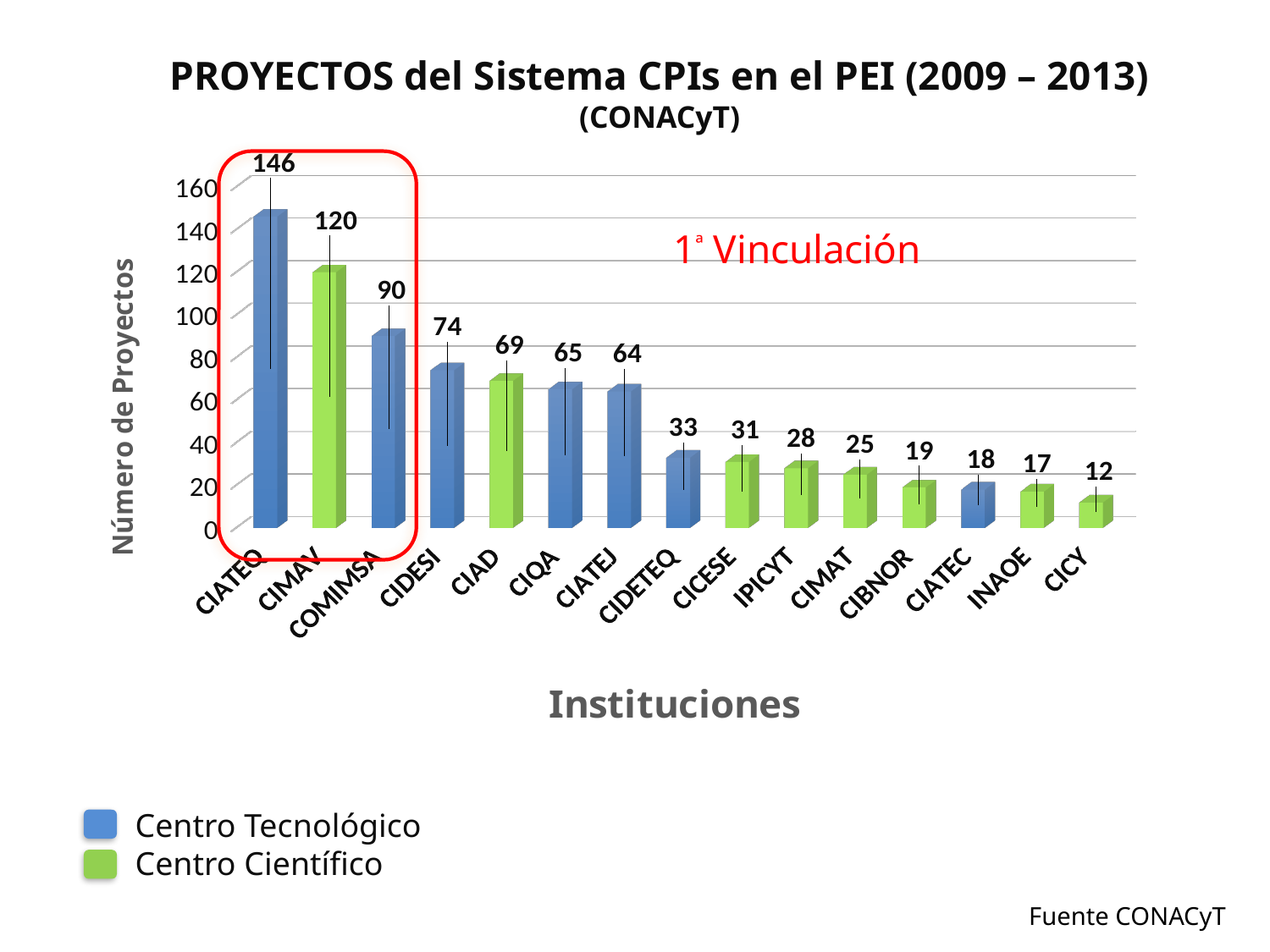
How many series does the legend list? 2 Which legend entry is shown in green? Centro Científico Which institution has the highest number of projects? CIATEQ What is the difference in number of projects between CIATEQ and CIMAV? 26 What is the number of projects for CIMAV? 120 What is the number of projects for CIATEQ? 146 What kind of chart is shown on the slide? Bar chart What is the number of projects for CIDETEQ? 33 How many institutions are shown on the x axis? 15 Which has more projects, CIDESI or CIAD? CIDESI Do the values rise or fall from left to right along the x axis? Fall Which institution has the lowest number of projects? CICY